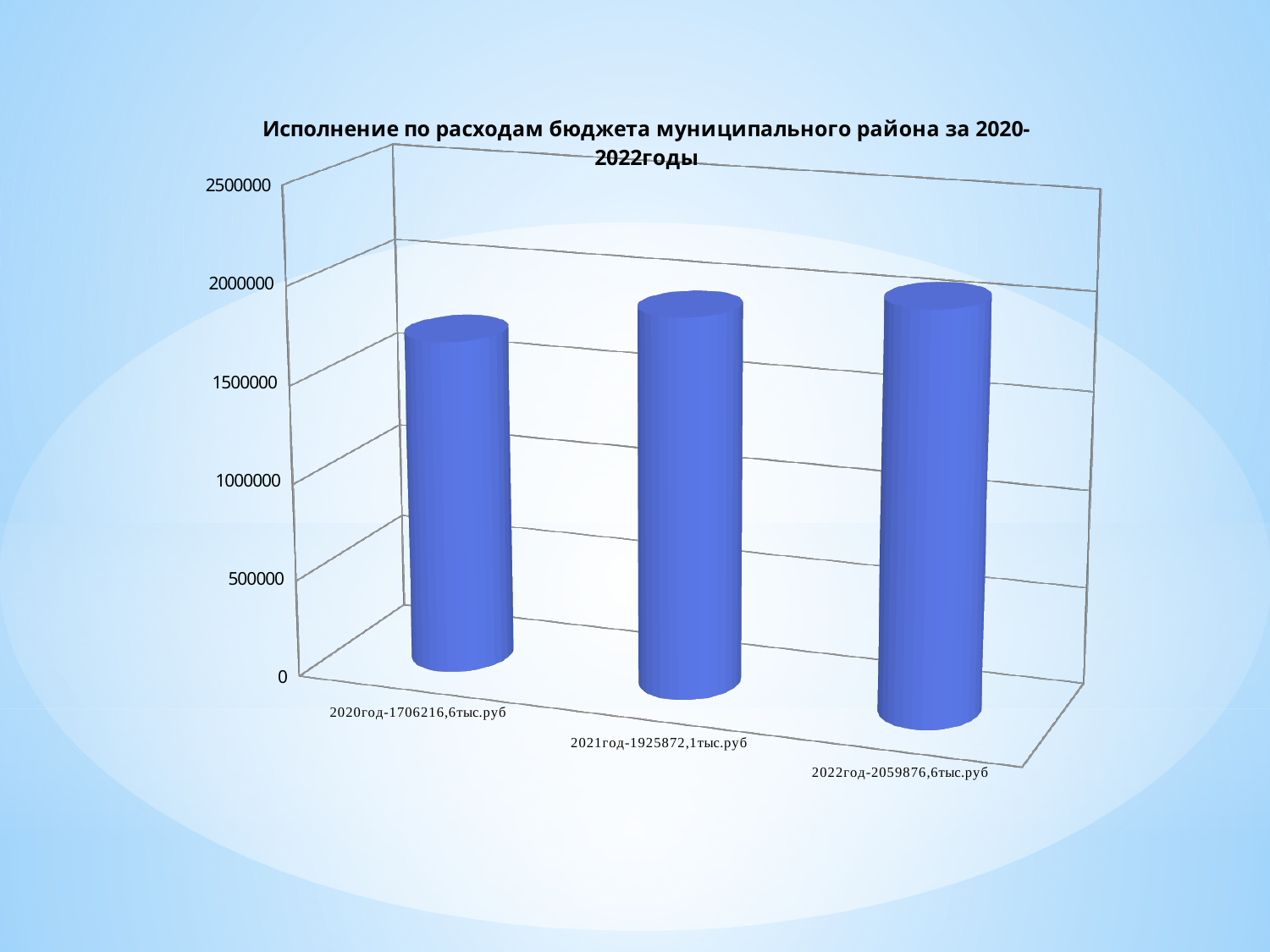
Which year has the highest budget expenditure? 2022 Do the expenditure values rise or fall from 2020 to 2022? rise What is the difference between the 2022 and 2021 expenditure values? 134004,5тыс.руб What is the budget expenditure value shown for 2021? 1925872,1тыс.руб What kind of chart is shown on the slide? bar chart What is the budget expenditure value shown for 2022? 2059876,6тыс.руб Which is larger, the expenditure for 2020 or for 2021? 2021 Which year has the lowest budget expenditure? 2020 What is the budget expenditure value shown for 2020? 1706216,6тыс.руб How many bars (years) are plotted in the chart? 3 What is the difference between the 2021 and 2020 expenditure values? 219655,5тыс.руб Is the value for 2020 greater or less than 2000000? less